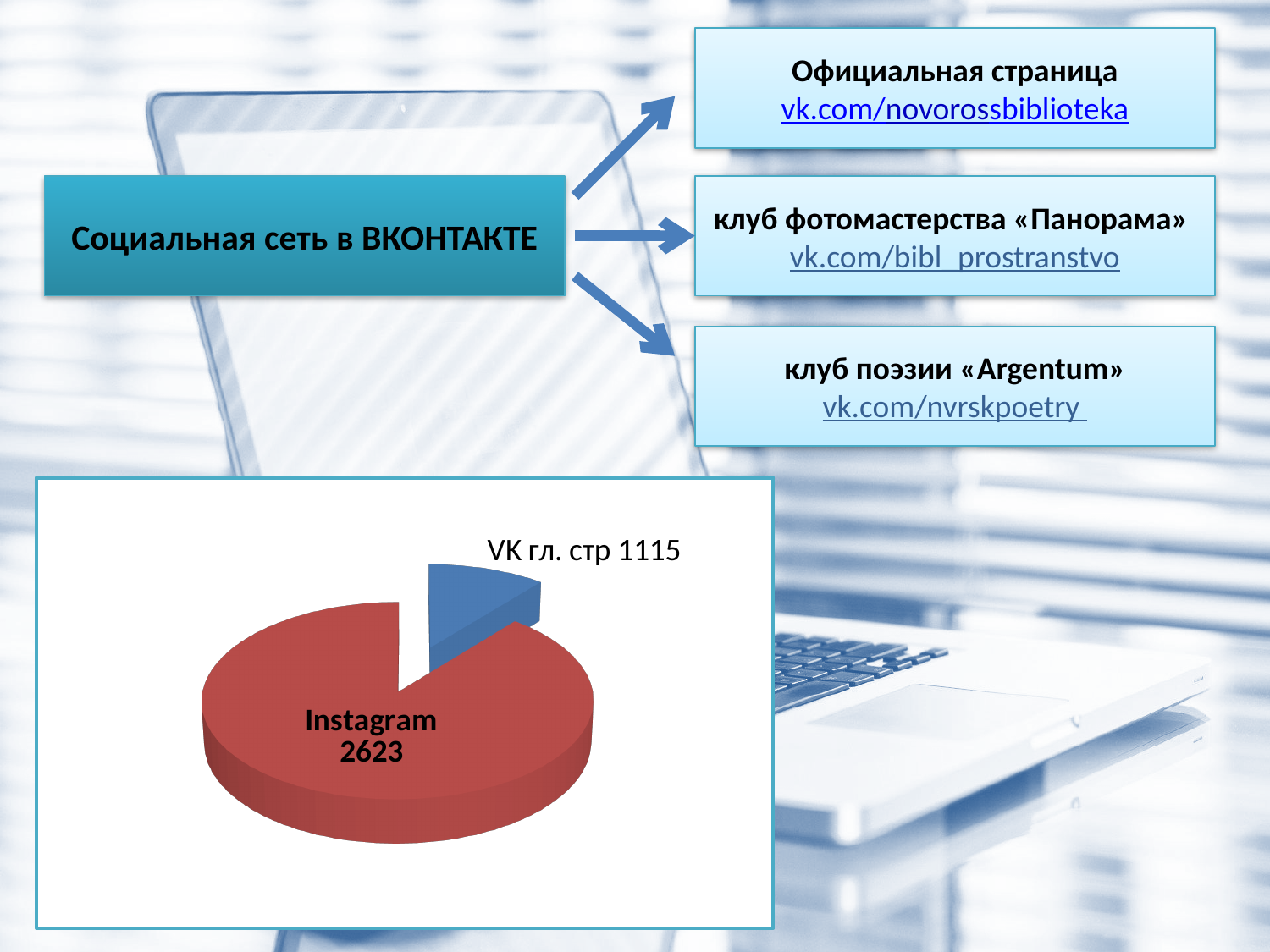
What colour is the Instagram slice in the pie chart? red What colour is the VK гл. стр slice in the pie chart? blue Which slice of the pie chart is the smallest? VK гл. стр What is the value shown for VK гл. стр in the pie chart? 1115 What is the total of the two values shown in the pie chart? 3738 What is the difference between the Instagram value and the VK гл. стр value in the pie chart? 1508 Which is larger in the pie chart, Instagram or VK гл. стр? Instagram What kind of chart is shown on the slide? pie chart How many slices does the pie chart have? 2 What is the value shown for Instagram in the pie chart? 2623 Which slice of the pie chart is the largest? Instagram